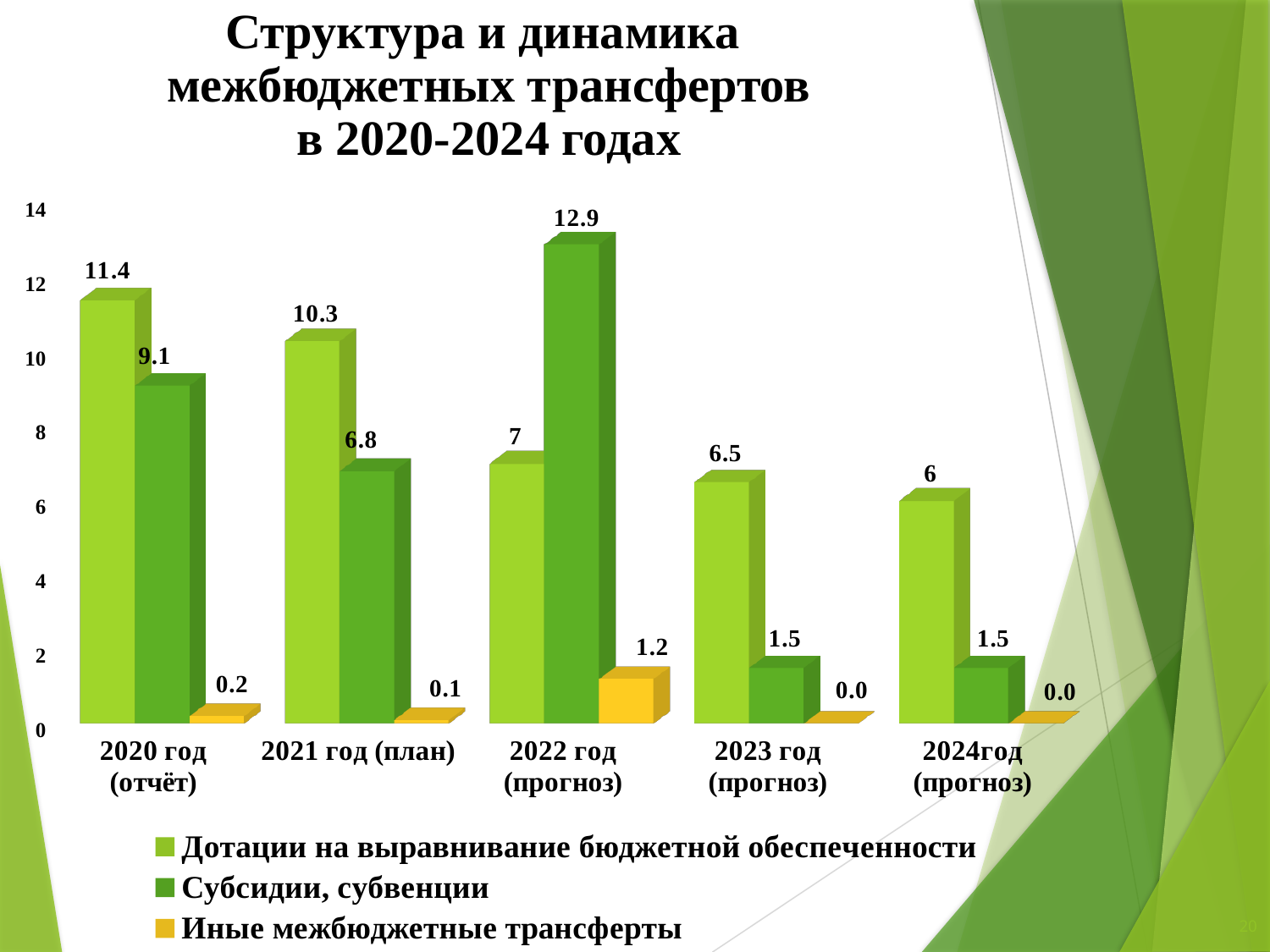
How many series does the legend list? 3 How many year categories are shown on the x axis? 5 Which is larger in 2022 год (прогноз): Дотации на выравнивание бюджетной обеспеченности or Субсидии, субвенции? Субсидии, субвенции What kind of chart is shown on the slide? Bar chart In which year is the Субсидии, субвенции value highest? 2022 год (прогноз) What is the difference between Дотации на выравнивание бюджетной обеспеченности and Субсидии, субвенции in 2021 год (план)? 3.5 What is the value of Иные межбюджетные трансферты for 2022 год (прогноз)? 1.2 Does the Дотации на выравнивание бюджетной обеспеченности value rise or fall from 2020 to 2024? Fall In which year is the Дотации на выравнивание бюджетной обеспеченности value lowest? 2024год (прогноз) What is the value of Субсидии, субвенции for 2022 год (прогноз)? 12.9 Which colour represents Иные межбюджетные трансферты in the chart? Yellow What is the value of Дотации на выравнивание бюджетной обеспеченности for 2020 год (отчёт)? 11.4